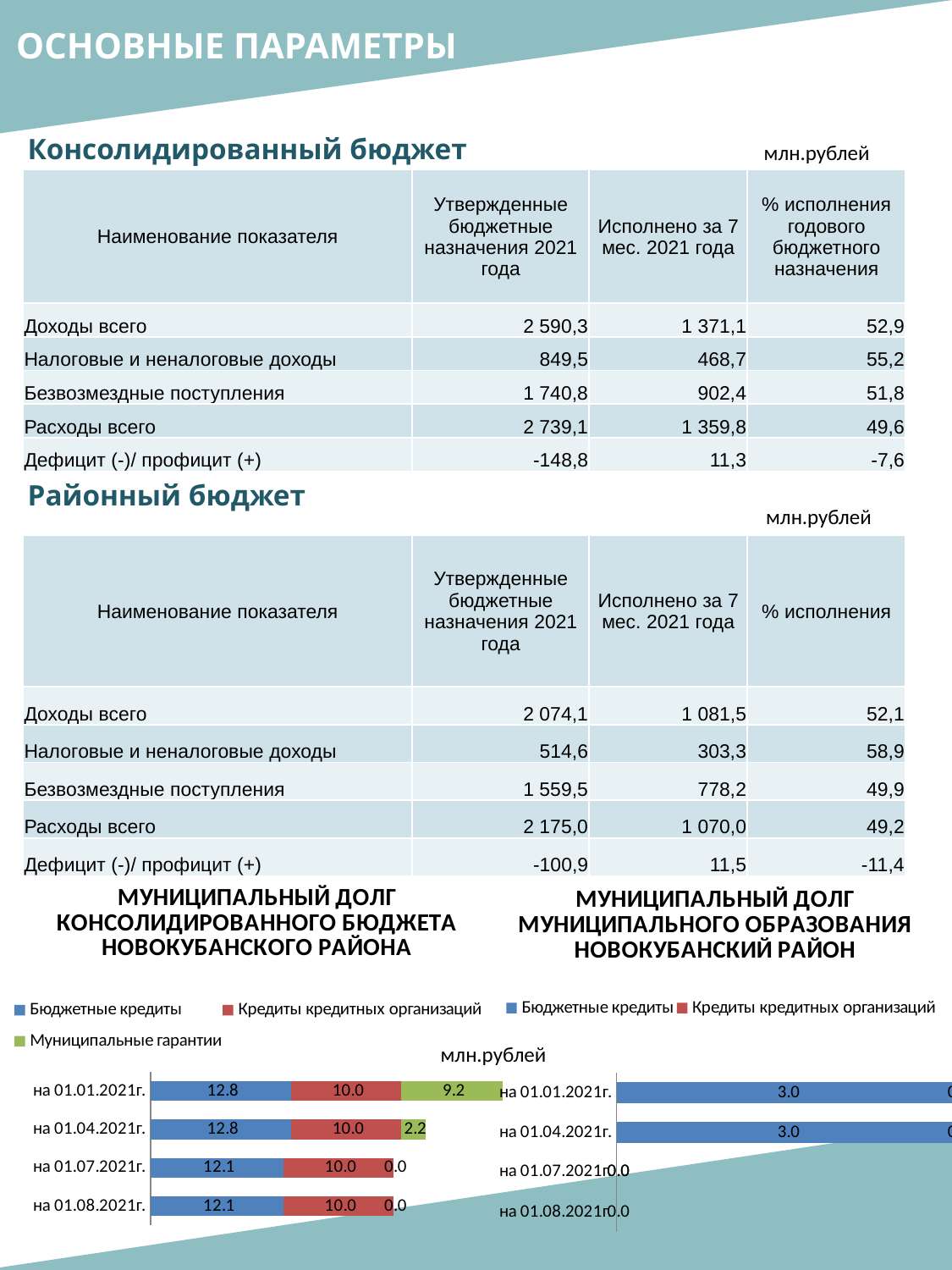
In the chart 'МУНИЦИПАЛЬНЫЙ ДОЛГ КОНСОЛИДИРОВАННОГО БЮДЖЕТА НОВОКУБАНСКОГО РАЙОНА', what is the value of 'Муниципальные гарантии' for 'на 01.04.2021г.'? 2.2 In the chart 'МУНИЦИПАЛЬНЫЙ ДОЛГ КОНСОЛИДИРОВАННОГО БЮДЖЕТА НОВОКУБАНСКОГО РАЙОНА', what is the difference between 'Муниципальные гарантии' for 'на 01.01.2021г.' and 'на 01.04.2021г.'? 7.0 In the chart 'МУНИЦИПАЛЬНЫЙ ДОЛГ КОНСОЛИДИРОВАННОГО БЮДЖЕТА НОВОКУБАНСКОГО РАЙОНА', what is the total of the stacked bar for 'на 01.01.2021г.'? 32.0 In the chart 'МУНИЦИПАЛЬНЫЙ ДОЛГ КОНСОЛИДИРОВАННОГО БЮДЖЕТА НОВОКУБАНСКОГО РАЙОНА', what is the value of 'Кредиты кредитных организаций' for 'на 01.08.2021г.'? 10.0 How many dates (categories) are shown in the chart 'МУНИЦИПАЛЬНЫЙ ДОЛГ КОНСОЛИДИРОВАННОГО БЮДЖЕТА НОВОКУБАНСКОГО РАЙОНА'? 4 In the chart 'МУНИЦИПАЛЬНЫЙ ДОЛГ КОНСОЛИДИРОВАННОГО БЮДЖЕТА НОВОКУБАНСКОГО РАЙОНА', what is the value of 'Бюджетные кредиты' for 'на 01.07.2021г.'? 12.1 In the chart 'МУНИЦИПАЛЬНЫЙ ДОЛГ КОНСОЛИДИРОВАННОГО БЮДЖЕТА НОВОКУБАНСКОГО РАЙОНА', what is the value of 'Бюджетные кредиты' for 'на 01.01.2021г.'? 12.8 In the chart 'МУНИЦИПАЛЬНЫЙ ДОЛГ КОНСОЛИДИРОВАННОГО БЮДЖЕТА НОВОКУБАНСКОГО РАЙОНА', for which date is 'Муниципальные гарантии' highest? на 01.01.2021г. In the chart 'МУНИЦИПАЛЬНЫЙ ДОЛГ КОНСОЛИДИРОВАННОГО БЮДЖЕТА НОВОКУБАНСКОГО РАЙОНА', what is the total of the stacked bar for 'на 01.08.2021г.'? 22.1 In the chart 'МУНИЦИПАЛЬНЫЙ ДОЛГ МУНИЦИПАЛЬНОГО ОБРАЗОВАНИЯ НОВОКУБАНСКИЙ РАЙОН', what is the value of 'Бюджетные кредиты' for 'на 01.04.2021г.'? 3.0 What kind of chart is 'МУНИЦИПАЛЬНЫЙ ДОЛГ КОНСОЛИДИРОВАННОГО БЮДЖЕТА НОВОКУБАНСКОГО РАЙОНА'? Stacked bar chart How many series does the legend of the chart 'МУНИЦИПАЛЬНЫЙ ДОЛГ КОНСОЛИДИРОВАННОГО БЮДЖЕТА НОВОКУБАНСКОГО РАЙОНА' list? 3